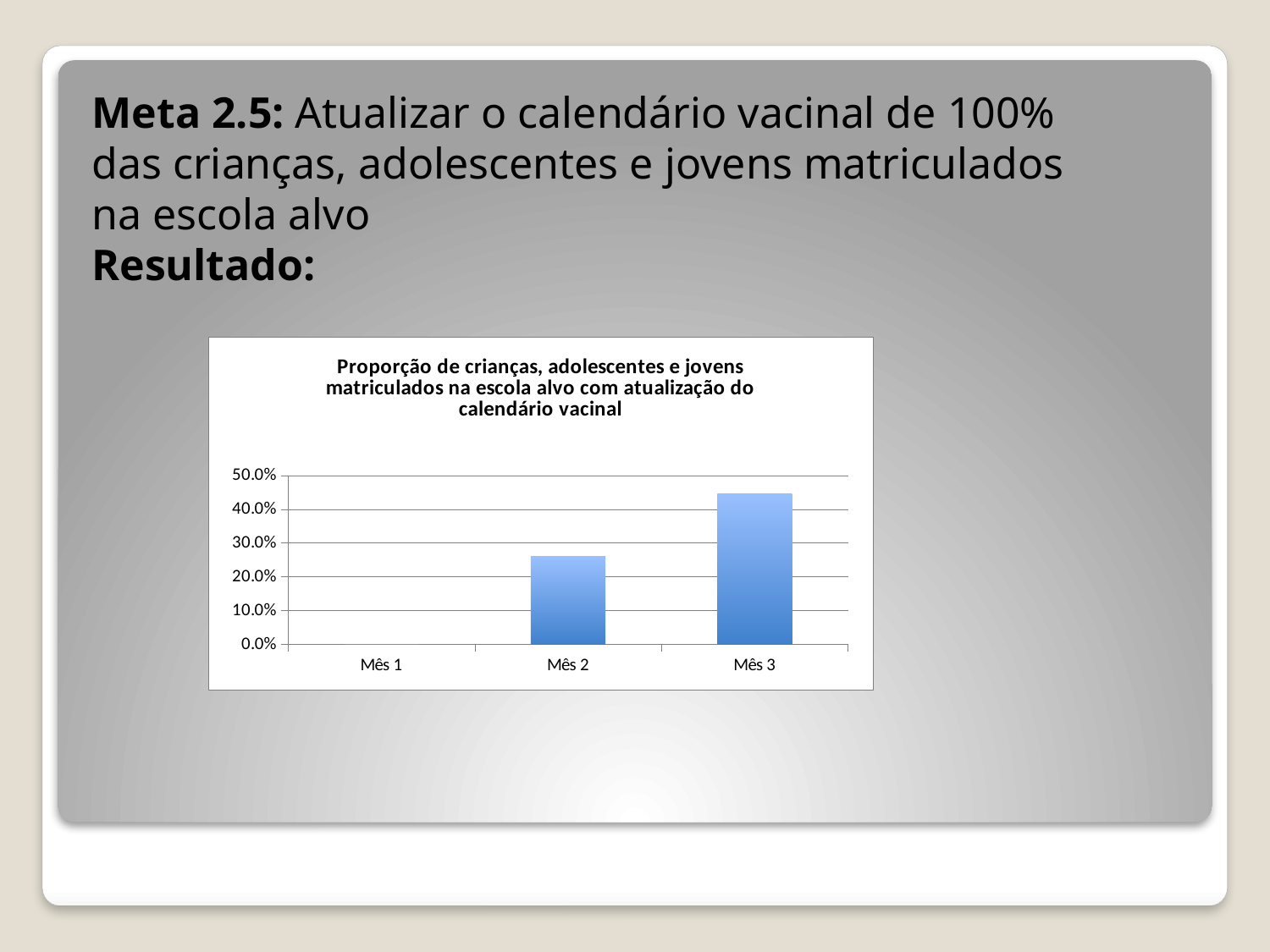
Is the value for Mês 2 greater or less than 20.0%? greater What is the title of the chart? Proporção de crianças, adolescentes e jovens matriculados na escola alvo com atualização do calendário vacinal Do the values rise or fall from Mês 1 to Mês 3? rise Is the value for Mês 3 greater or less than 50.0%? less Is the value for Mês 2 greater or less than 30.0%? less What is the highest value shown on the chart's vertical axis? 50.0% Which month has the lowest proportion in the chart? Mês 1 What kind of chart is shown on the slide? bar chart Which month has the highest proportion in the chart? Mês 3 How many categories are shown on the x axis of the chart? 3 Which is larger, the value for Mês 2 or the value for Mês 3? Mês 3